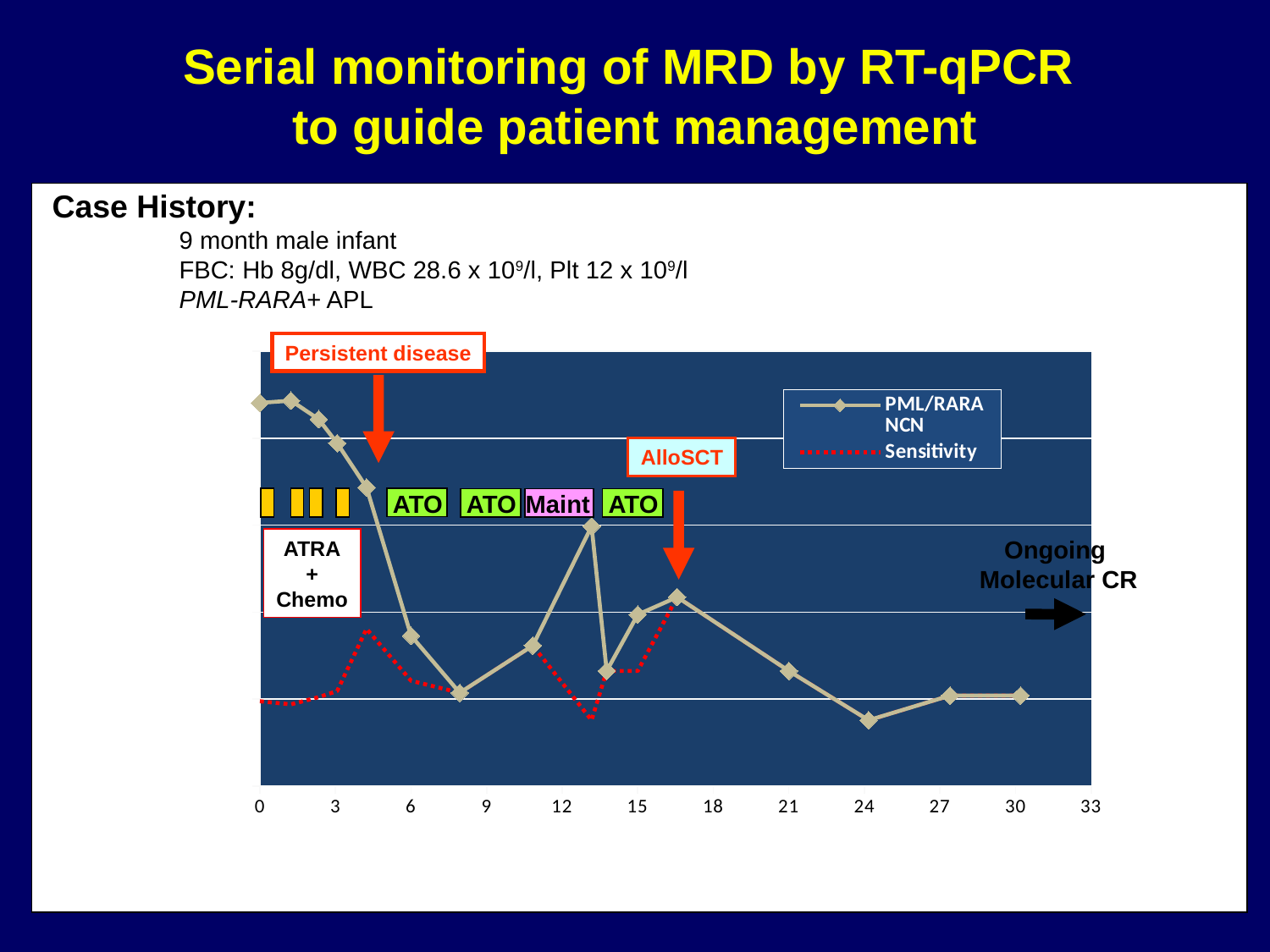
What kind of chart is shown on the slide? line chart Between x = 6 and x = 8, does the PML/RARA NCN series rise or fall? fall At which x-axis value does the PML/RARA NCN series reach its lowest point? 24 Which series is drawn as a red dotted line? Sensitivity What is the highest value shown on the x axis? 33 How many series does the chart legend list? 2 What is the interval between consecutive tick labels on the x axis? 3 Between x = 8 and x = 13, does the PML/RARA NCN series rise or fall? rise Is the PML/RARA NCN value at x = 0 higher or lower than its value at x = 24? higher Does the PML/RARA NCN series overall rise or fall from the left of the x axis to the right? fall What are the two series named in the chart legend? PML/RARA NCN and Sensitivity How many tick labels are shown on the x axis? 12